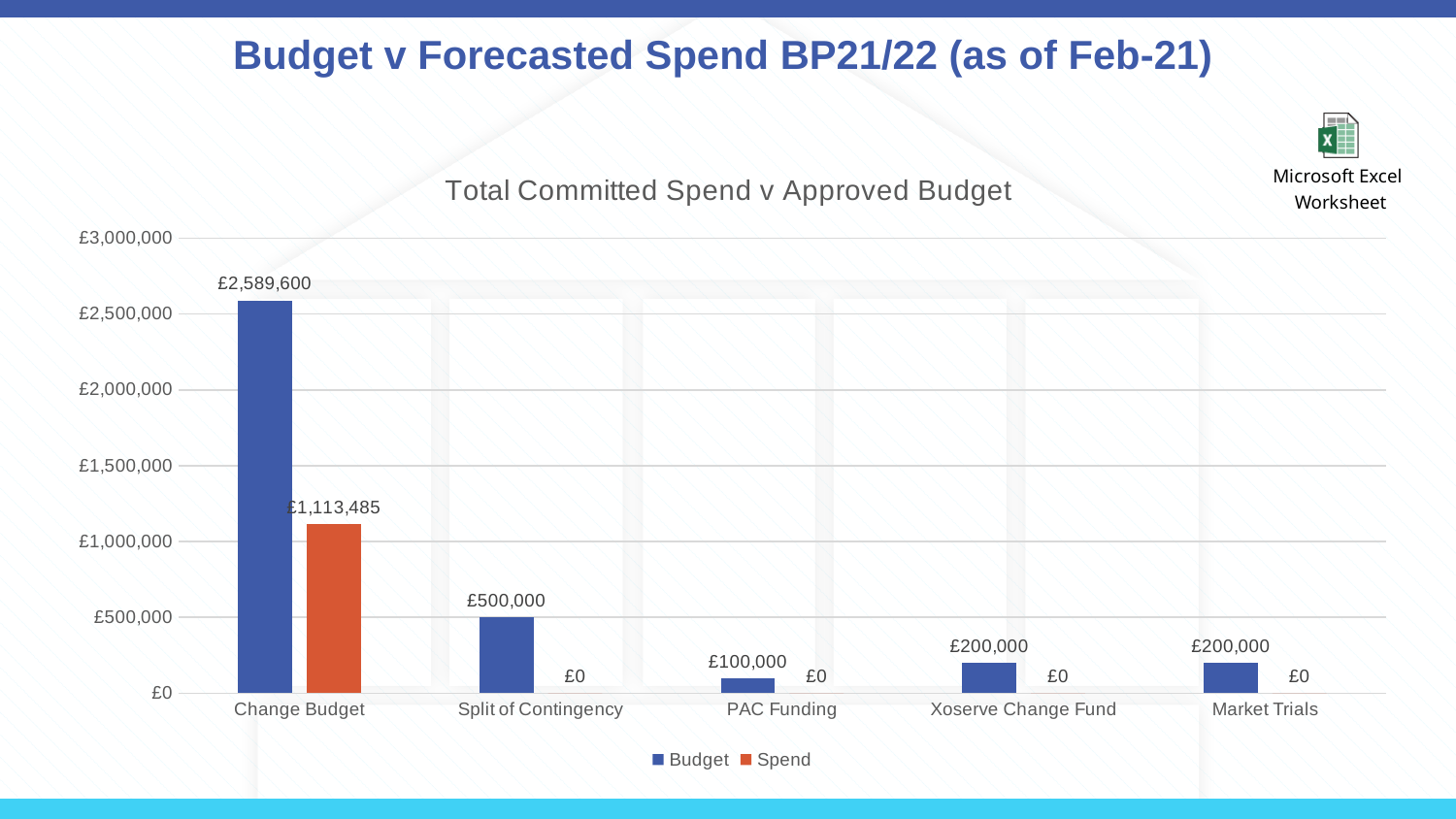
What is the Budget value for Split of Contingency? £500,000 What type of chart is shown on the slide? Bar chart Which category has the lowest Budget value? PAC Funding How many series does the legend list? 2 What is the Spend value for Change Budget? £1,113,485 Which category has the highest Budget value? Change Budget What is the Spend value for Market Trials? £0 What is the Budget value for Change Budget? £2,589,600 How many categories are shown on the x axis? 5 What is the difference between the Budget and Spend values for Change Budget? £1,476,115 What is the Budget value for PAC Funding? £100,000 Which is larger, the Budget for Split of Contingency or the Budget for Xoserve Change Fund? Budget for Split of Contingency